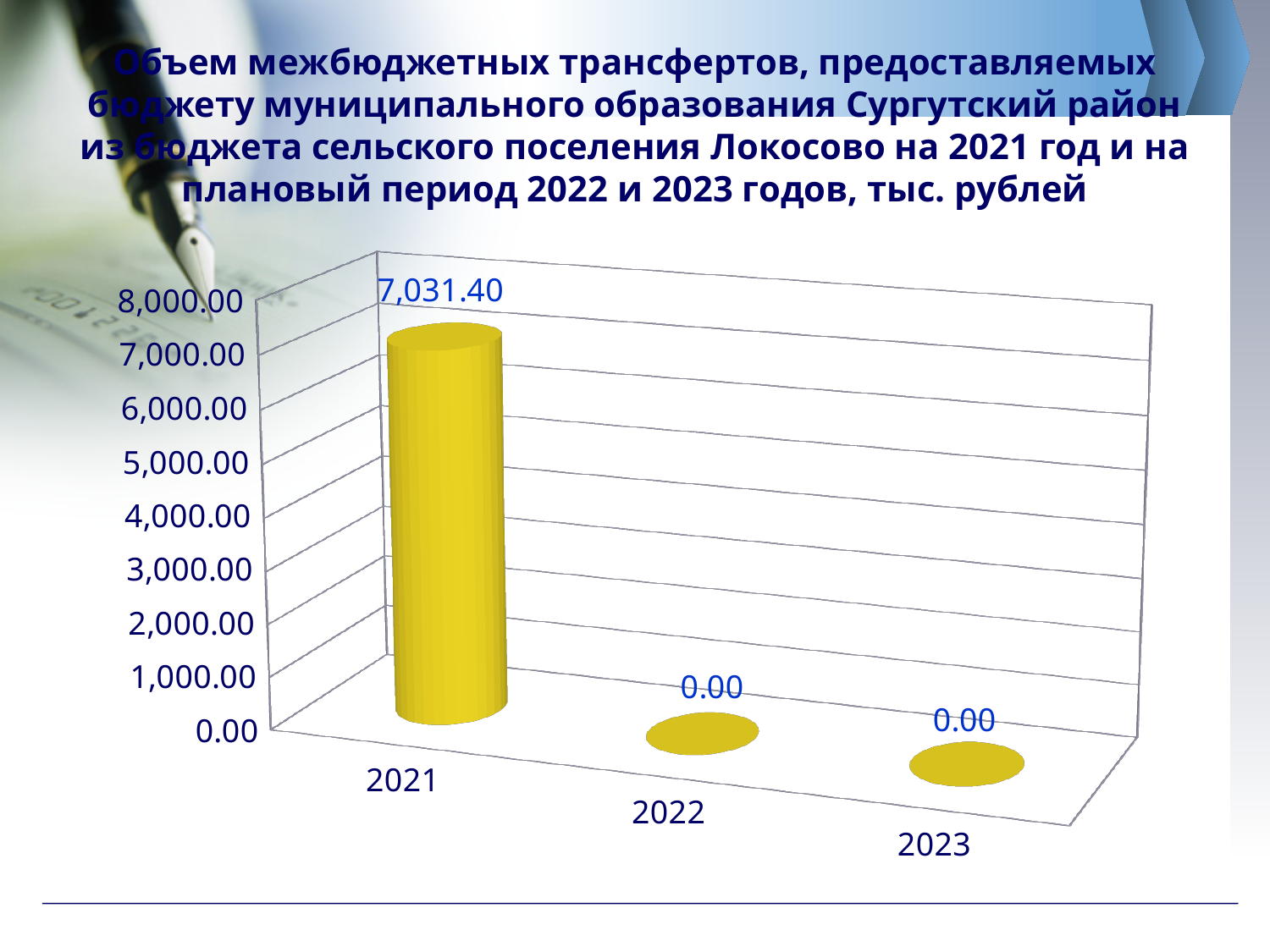
How many years are shown on the x axis? 3 What is the value for 2021? 7,031.40 Which is larger, the value for 2021 or the value for 2023? 2021 What kind of chart is shown on the slide? bar chart Which year has the highest value? 2021 Is the value for 2021 greater or less than 8,000.00? less Is the value for 2021 greater or less than 7,000.00? greater What is the value for 2022? 0.00 Do the values rise or fall from 2021 to 2023? fall What is the highest value shown on the vertical axis? 8,000.00 What is the difference between the values for 2021 and 2022? 7,031.40 What is the value for 2023? 0.00